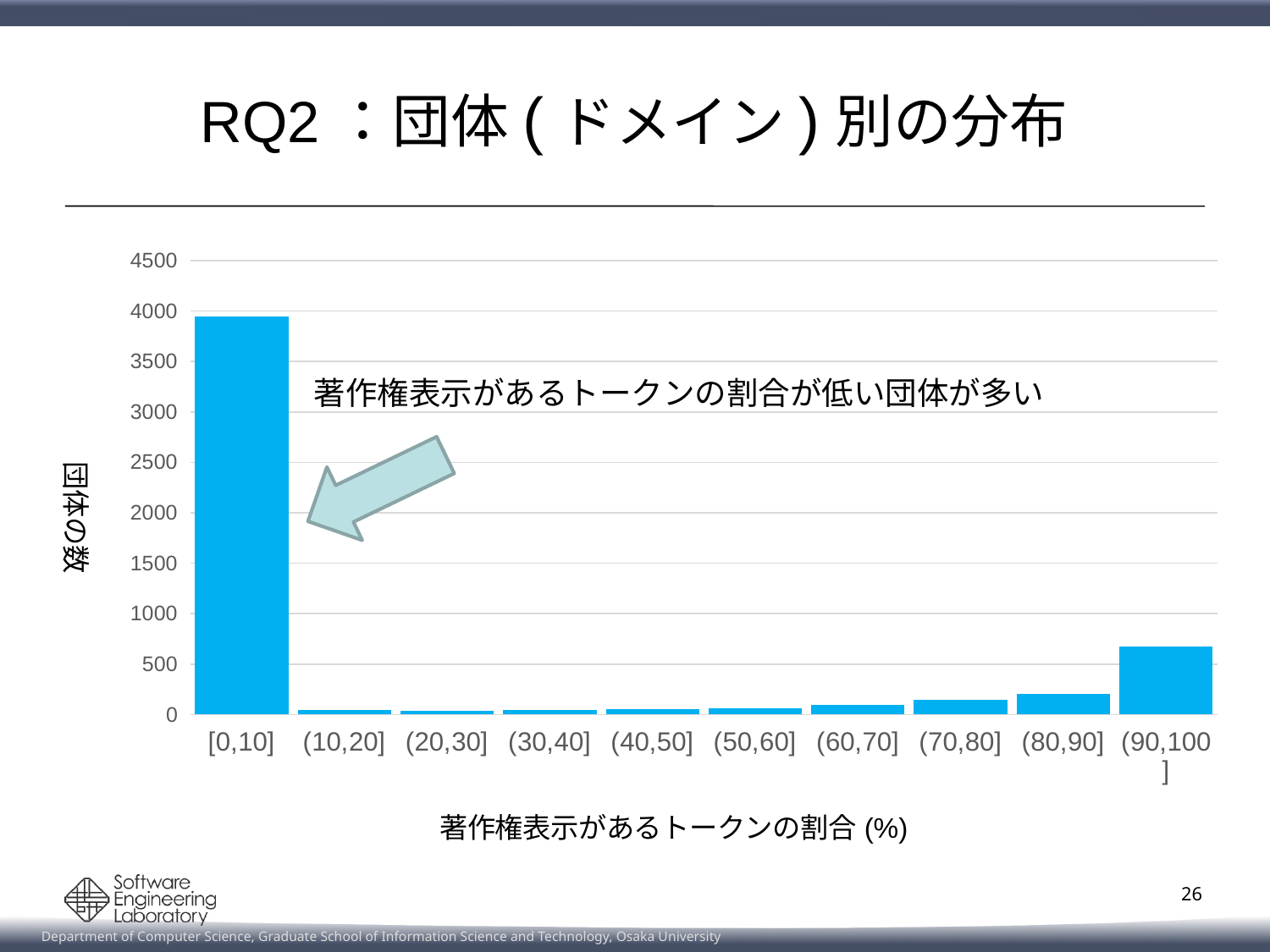
From (50,60] to (90,100], do the bar values rise or fall along the x axis? rise Which is larger, the value for [0,10] or the value for (90,100]? [0,10] Is the value for [0,10] greater or less than 3500? greater What kind of chart is shown on the slide? bar chart Which category has the highest number of 団体 (organizations)? [0,10] What is the x-axis title of the chart? 著作権表示があるトークンの割合 (%) Is the value for (90,100] greater or less than 1000? less Which is larger, the value for (60,70] or the value for (80,90]? (80,90] Is the value for (90,100] greater or less than 500? greater Which is larger, the value for (90,100] or the value for (80,90]? (90,100] How many categories (bins) are shown on the x axis of the chart? 10